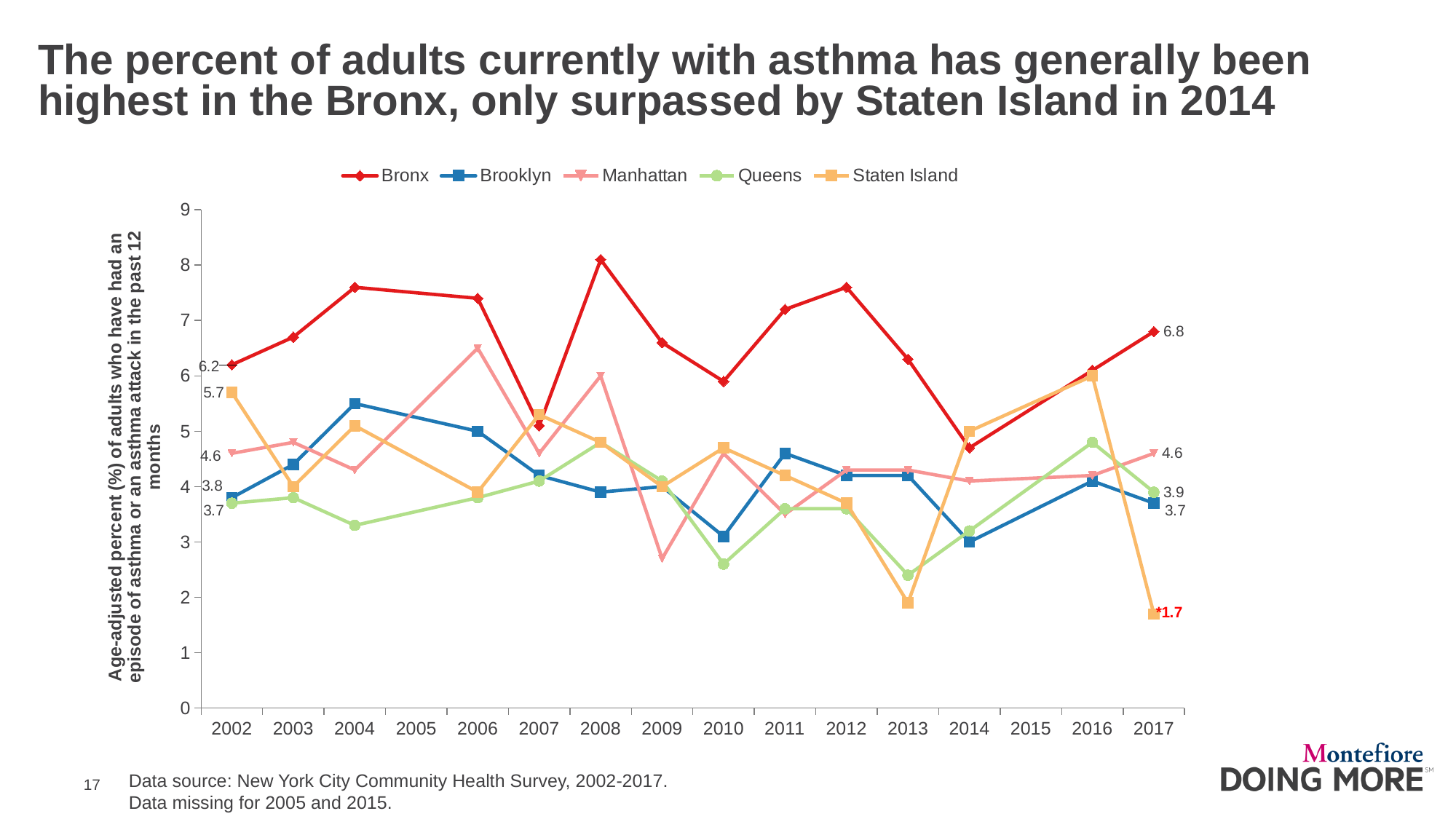
What was the age-adjusted percent of adults with asthma in the Bronx in 2002? 6.2 What was the value for Manhattan in 2017? 4.6 What was the value for Queens in 2002? 3.7 By how much did the Bronx value in 2017 exceed its value in 2002? 0.6 Is the Bronx value in 2008 greater or less than 8? greater What kind of chart is shown on the slide? line chart How many series does the legend list? 5 Which borough had the lowest value in 2017? Staten Island In 2002, which had the higher value: the Bronx or Staten Island? Bronx What is the difference between the Bronx and Brooklyn values in 2017? 3.1 What was the value for Brooklyn in 2017? 3.7 Which borough had the highest value in 2017? Bronx